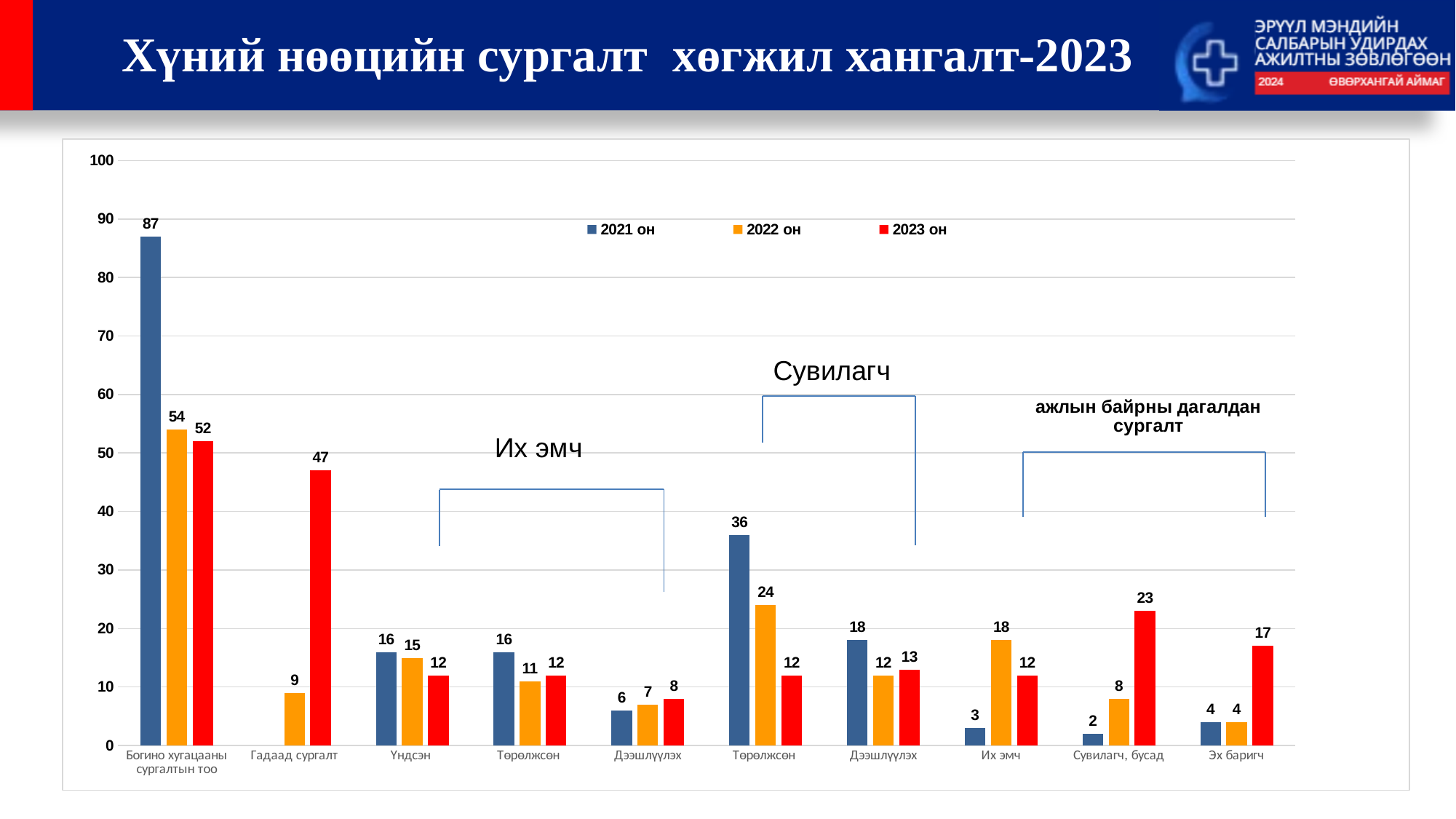
What is the value for 2023 он in the category Сувилагч, бусад? 23 What is the value for 2022 он in the category Их эмч? 18 How many series does the legend list? 3 Which category has the highest value for 2021 он? Богино хугацааны сургалтын тоо What is the value for 2021 он in the category Богино хугацааны сургалтын тоо? 87 Which category has the lowest value for 2021 он? Сувилагч, бусад What type of chart is shown on the slide? bar chart Which series is shown in red in the legend? 2023 он Which is larger in the category Эх баригч: the value for 2022 он or for 2023 он? 2023 он What is the difference between the 2021 он and 2023 он values in the category Богино хугацааны сургалтын тоо? 35 What is the value for 2023 он in the category Гадаад сургалт? 47 How many categories are shown along the x axis? 10